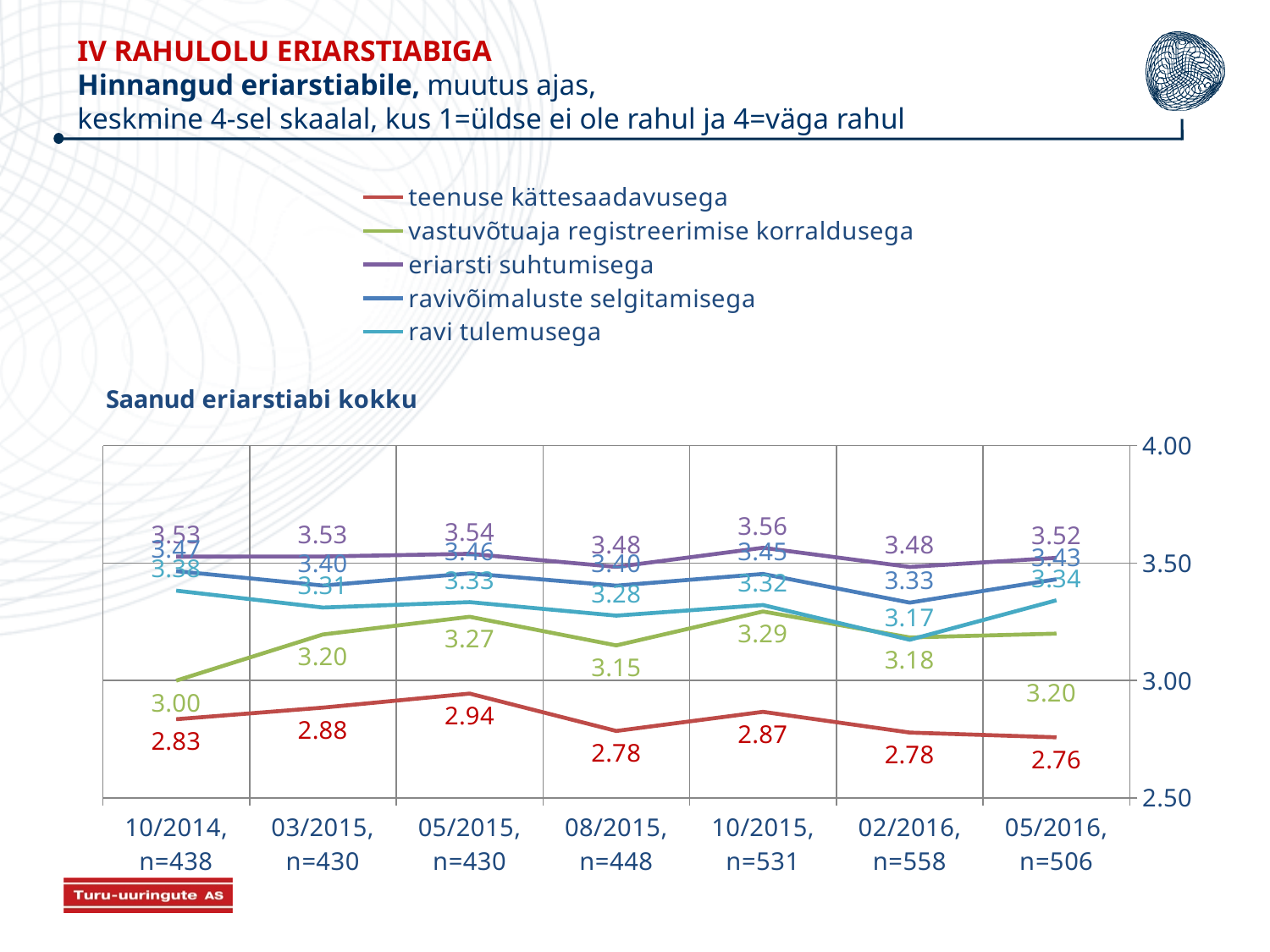
What is the value for 'vastuvõtuaja registreerimise korraldusega' at 08/2015, n=448? 3.15 Which series has the lowest values across all time points? teenuse kättesaadavusega What is the value for 'teenuse kättesaadavusega' at 05/2015, n=430? 2.94 Is the value for 'vastuvõtuaja registreerimise korraldusega' at 10/2015, n=531 greater or less than 3.50? less What is the difference between the 'eriarsti suhtumisega' value and the 'teenuse kättesaadavusega' value at 05/2016, n=506? 0.76 At which time point is the value for 'teenuse kättesaadavusega' the highest? 05/2015, n=430 How many series does the legend list? 5 What is the value for 'eriarsti suhtumisega' at 10/2015, n=531? 3.56 How many time points are plotted along the x axis? 7 At which time point is the value for 'teenuse kättesaadavusega' the lowest? 05/2016, n=506 What kind of chart is shown on the slide? line chart What is the value for 'ravi tulemusega' at 02/2016, n=558? 3.17